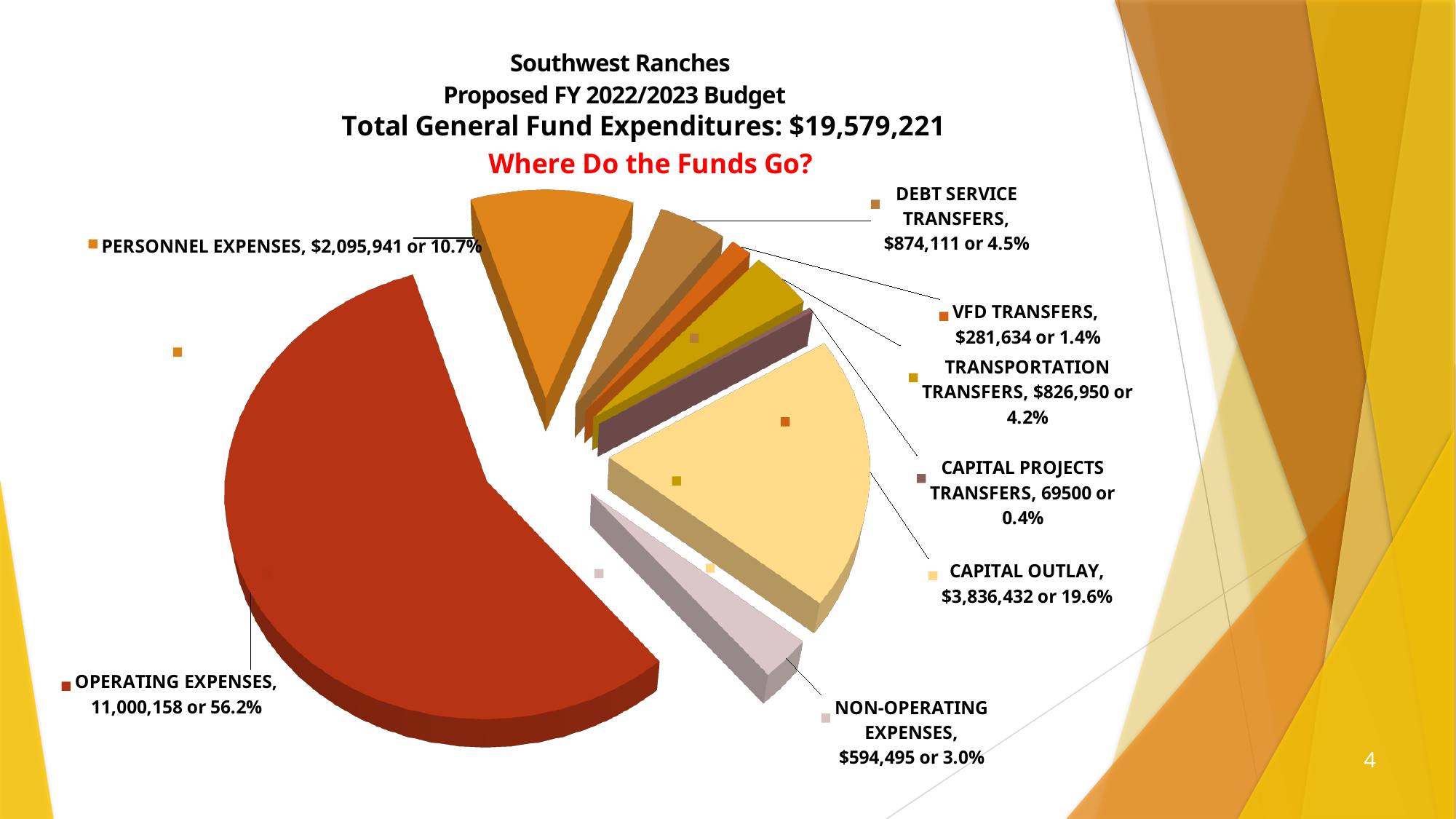
Which category has the largest share of the pie? Operating Expenses Which category has the smallest share of the pie? Capital Projects Transfers What is the difference in percentage points between Capital Outlay (19.6%) and Personnel Expenses (10.7%)? 8.9 percentage points What is the dollar amount shown for Debt Service Transfers? $874,111 How many categories (slices) does the pie chart show? 8 What total general fund expenditure amount is stated in the chart title? $19,579,221 What kind of chart is shown on the slide? Pie chart Which is larger, Transportation Transfers or VFD Transfers? Transportation Transfers What is the value shown for Capital Outlay? $3,836,432 or 19.6% What share of the pie is Non-Operating Expenses? 3.0% What percentage of the funds goes to Personnel Expenses? 10.7% What is the red subtitle question shown above the pie chart? Where Do the Funds Go?